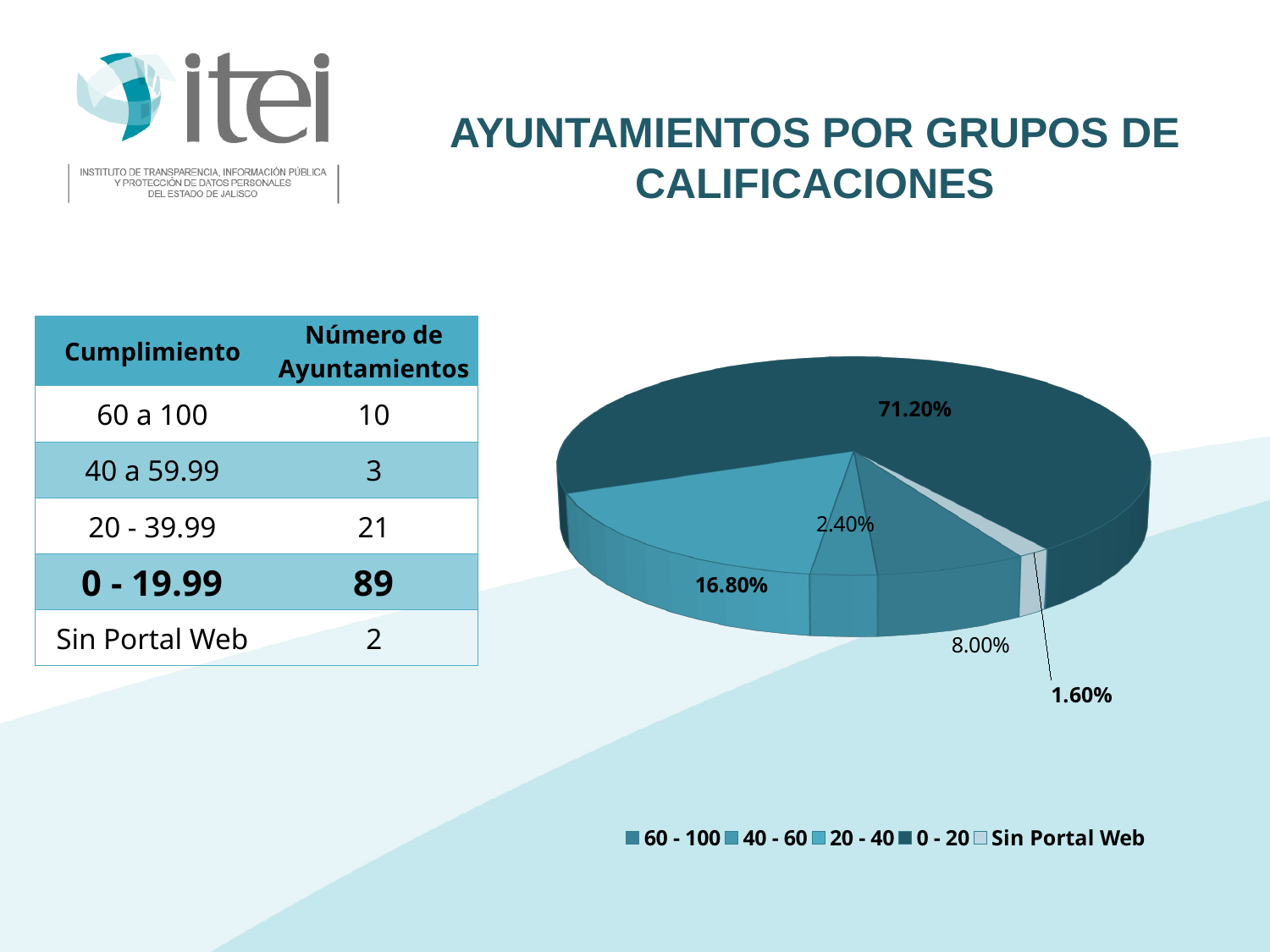
What is the largest percentage shown on the pie chart? 71.20% How many categories does the legend of the pie chart list? 5 Which legend entry appears last in the pie chart's legend? Sin Portal Web What is the title of the chart on the slide? AYUNTAMIENTOS POR GRUPOS DE CALIFICACIONES What type of chart is shown on the slide? pie chart Which category has the largest slice of the pie chart? 0 - 20 What share of the pie does the '0 - 20' slice represent? 71.20% What share of the pie does the 'Sin Portal Web' slice represent? 1.60% What is the difference between the 71.20% slice and the 16.80% slice? 54.40% What is the smallest percentage shown on the pie chart? 1.60% Which is larger, the slice labelled 16.80% or the slice labelled 8.00%? 16.80% How many slices does the pie chart have? 5